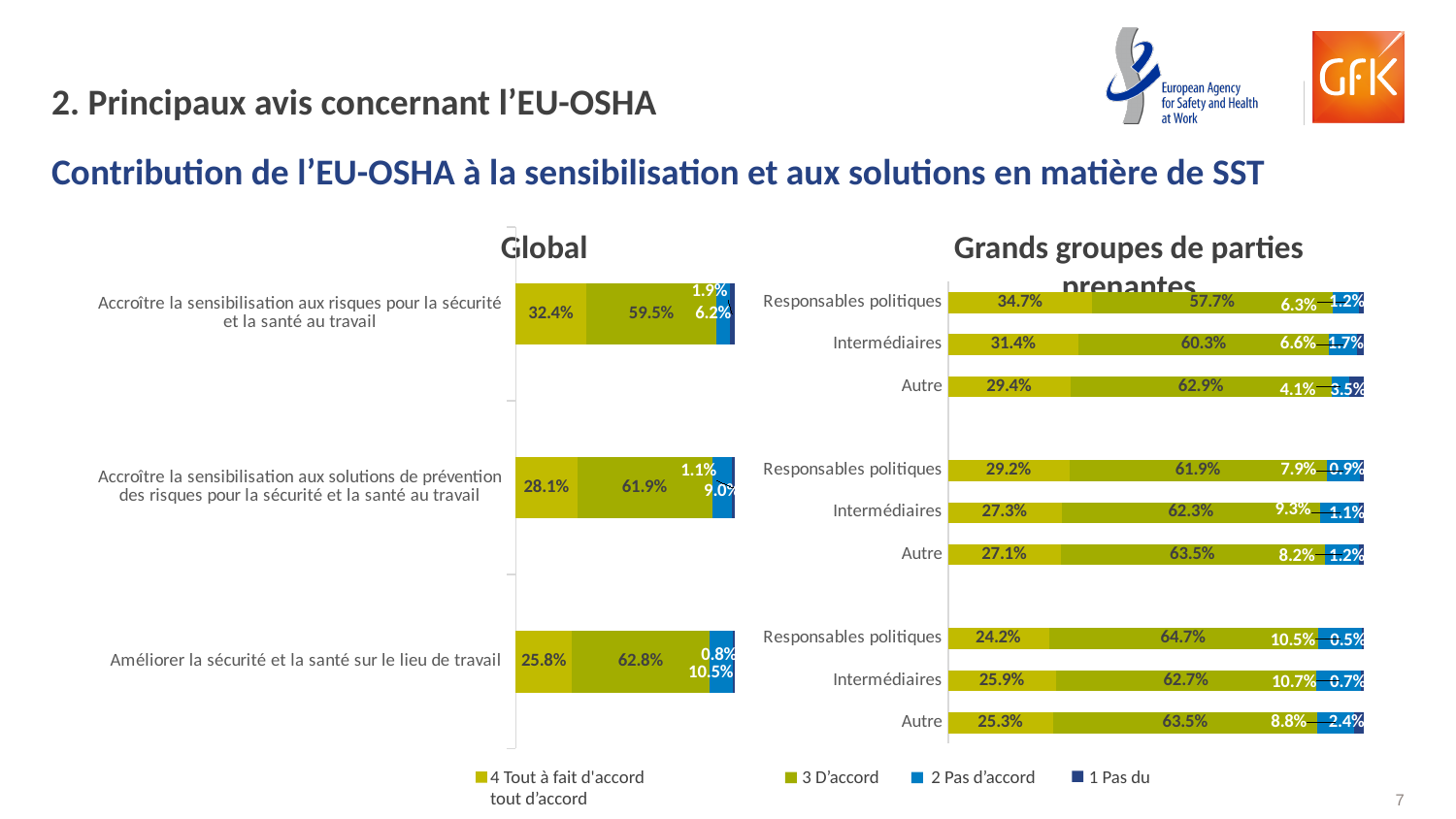
How many series does the legend list? 4 In the Global chart, what percentage answered "4 Tout à fait d'accord" for "Accroître la sensibilisation aux risques pour la sécurité et la santé au travail"? 32.4% In the Global chart, what is the difference between the "3 D'accord" share for "Améliorer la sécurité et la santé sur le lieu de travail" and for "Accroître la sensibilisation aux risques pour la sécurité et la santé au travail"? 3.3 percentage points What kind of chart is the Global chart? Stacked bar chart How many bars are shown in the Global chart? 3 In the Global chart, which statement has the highest "4 Tout à fait d'accord" share? Accroître la sensibilisation aux risques pour la sécurité et la santé au travail In the Grands groupes de parties prenantes chart, what is the "4 Tout à fait d'accord" share for Responsables politiques in the first (top) group of bars? 34.7% In the Global chart, which statement has the lowest "2 Pas d'accord" share? Accroître la sensibilisation aux risques pour la sécurité et la santé au travail In the Global chart, what percentage answered "3 D'accord" for "Améliorer la sécurité et la santé sur le lieu de travail"? 62.8% In the Grands groupes de parties prenantes chart, in the third (bottom) group of bars, which is larger: the "2 Pas d'accord" share for Intermédiaires or for Autre? Intermédiaires In the Grands groupes de parties prenantes chart, what is the "3 D'accord" share for Autre in the second (middle) group of bars? 63.5% In the Global chart, what percentage answered "2 Pas d'accord" for "Accroître la sensibilisation aux solutions de prévention des risques pour la sécurité et la santé au travail"? 9.0%